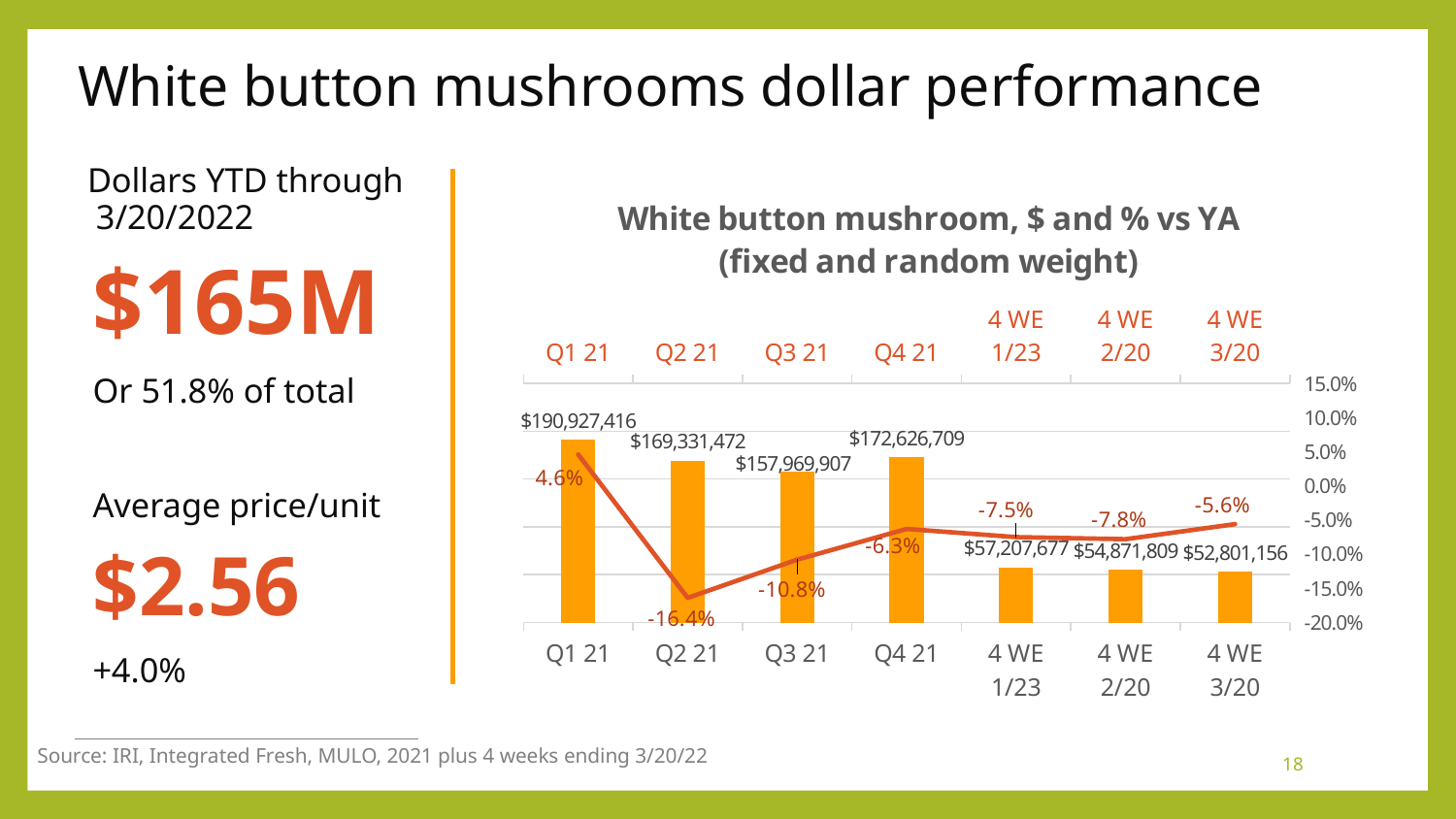
What is the % vs YA value shown for 4 WE 2/20? -7.8% What kind of chart is this? Combination bar and line chart What is the title of the chart? White button mushroom, $ and % vs YA (fixed and random weight) Which period has the lowest dollar value? 4 WE 3/20 Which period has the lowest % vs YA value? Q2 21 What is the % vs YA value shown for Q2 21? -16.4% Which is larger, the dollar value for Q3 21 or Q4 21? Q4 21 How many periods are shown on the x axis? 7 Which period has the highest dollar value? Q1 21 What is the difference in dollar value between Q1 21 and Q2 21? $21,595,944 What is the dollar value shown for 4 WE 3/20? $52,801,156 What is the dollar value shown for Q1 21? $190,927,416